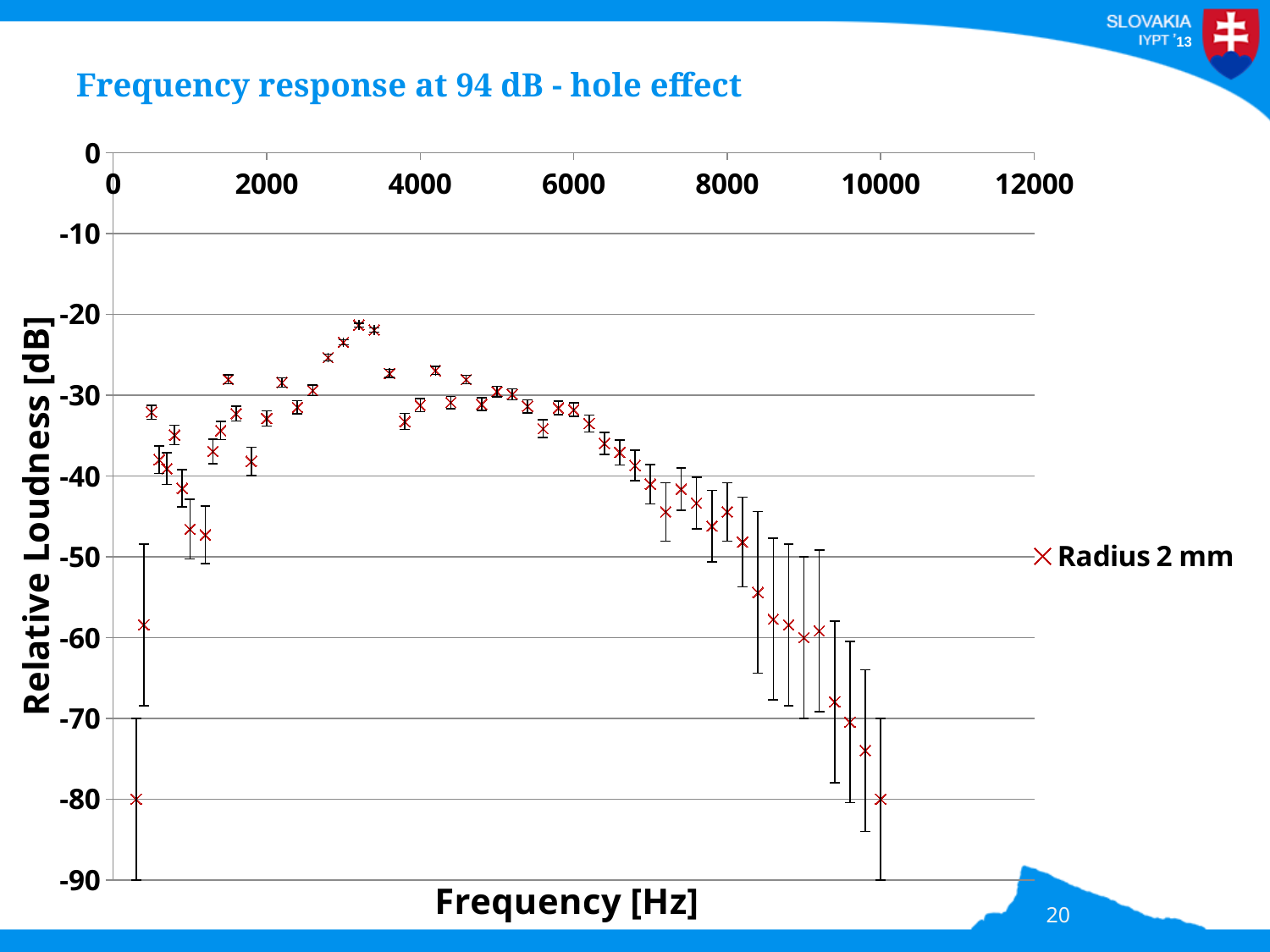
Is the highest plotted value located between 2000 Hz and 4000 Hz, or between 8000 Hz and 10000 Hz? between 2000 Hz and 4000 Hz What is the highest frequency tick shown on the x axis? 12000 What is the name of the series shown in the legend? Radius 2 mm How many series does the legend list? 1 Is the value at 6000 Hz larger than the value at 10000 Hz? yes What is the label of the vertical axis? Relative Loudness [dB] Is the value at 4000 Hz greater or less than -30? less What kind of chart is shown on the slide? scatter chart Is the highest plotted value greater or less than -30? greater Is the value at 8000 Hz greater or less than -40? less Do the values rise or fall along the x axis between 4000 Hz and 10000 Hz? fall